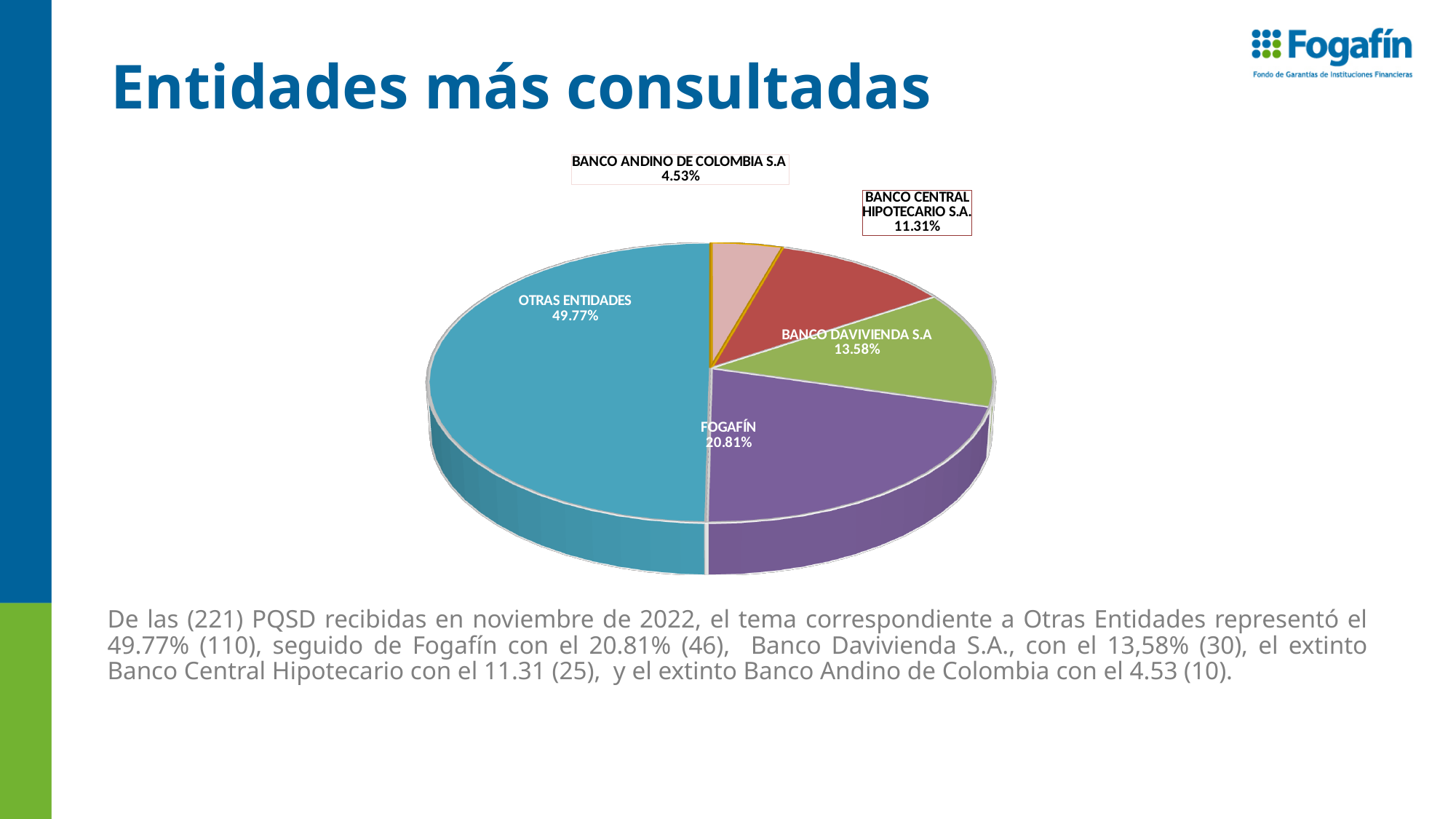
What is the value shown for BANCO ANDINO DE COLOMBIA S.A? 4.53% Which category has the smallest slice of the pie? BANCO ANDINO DE COLOMBIA S.A What is the title of the slide containing the chart? Entidades más consultadas Which category has the largest slice of the pie? OTRAS ENTIDADES What is the value shown for BANCO CENTRAL HIPOTECARIO S.A.? 11.31% What share of the pie does OTRAS ENTIDADES represent? 49.77% What is the value shown for BANCO DAVIVIENDA S.A? 13.58% Which is larger, the slice for BANCO CENTRAL HIPOTECARIO S.A. or the slice for BANCO ANDINO DE COLOMBIA S.A? BANCO CENTRAL HIPOTECARIO S.A. What is the value shown for FOGAFÍN? 20.81% How many slices does the pie chart have? 5 What is the difference in percentage points between FOGAFÍN and BANCO DAVIVIENDA S.A? 7.23 What kind of chart is shown on the slide? Pie chart